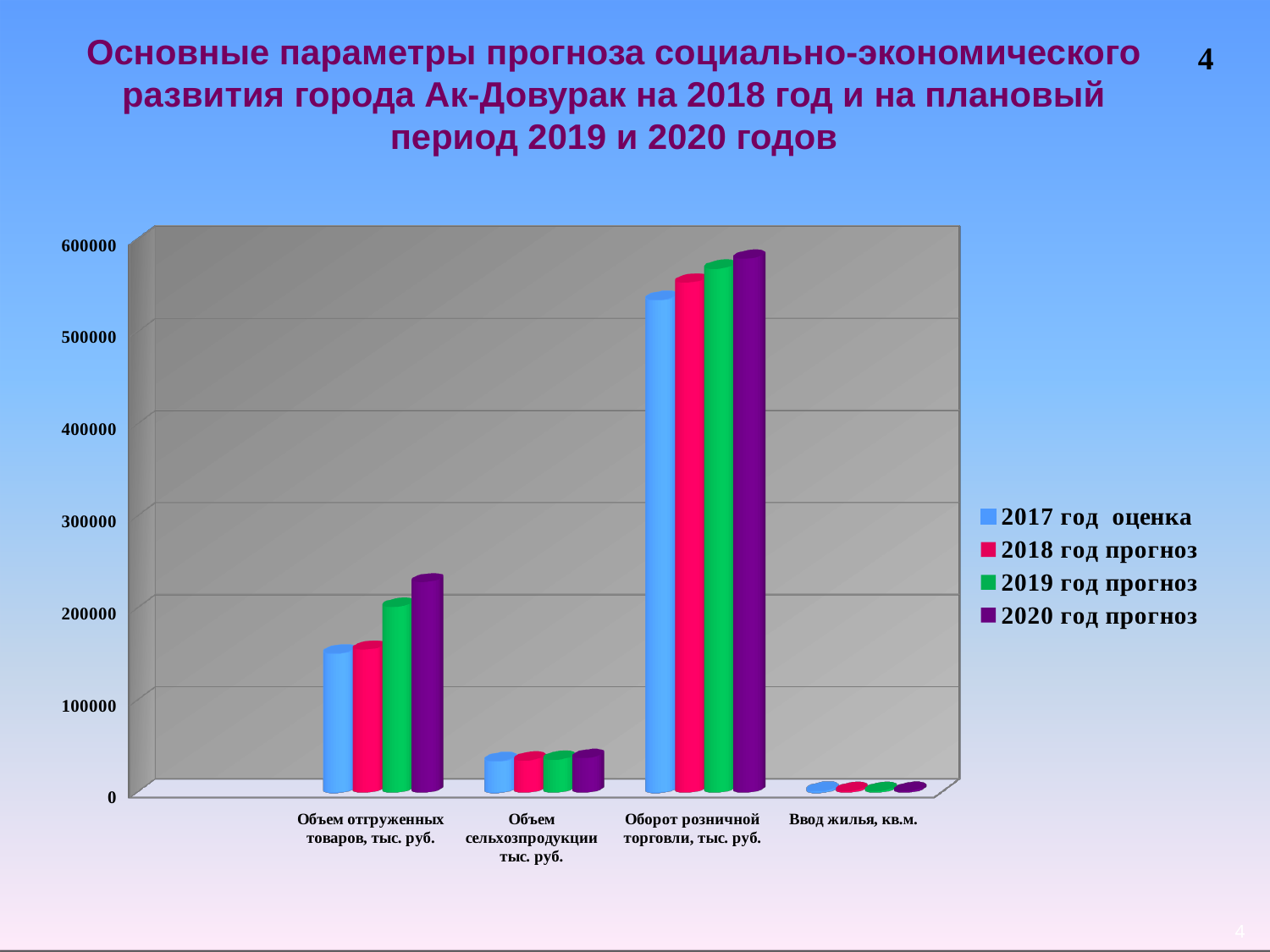
Is the value for Оборот розничной торговли in 2017 год оценка greater or less than 500000? greater Is the value for Объем отгруженных товаров in 2020 год прогноз greater or less than 200000? greater How many categories are shown on the x axis of the chart? 4 Which category has the lowest bars in the chart? Ввод жилья, кв.м. Which category has the highest bars in the chart? Оборот розничной торговли, тыс. руб. Which series is shown in purple in the chart legend? 2020 год прогноз What kind of chart is shown on the slide? bar chart How many series does the chart legend list? 4 Is the value for Объем сельхозпродукции in 2018 год прогноз greater or less than 100000? less For Объем отгруженных товаров, which is larger: the 2017 год оценка value or the 2020 год прогноз value? 2020 год прогноз Do the values for Объем отгруженных товаров rise or fall from 2017 год оценка to 2020 год прогноз? rise